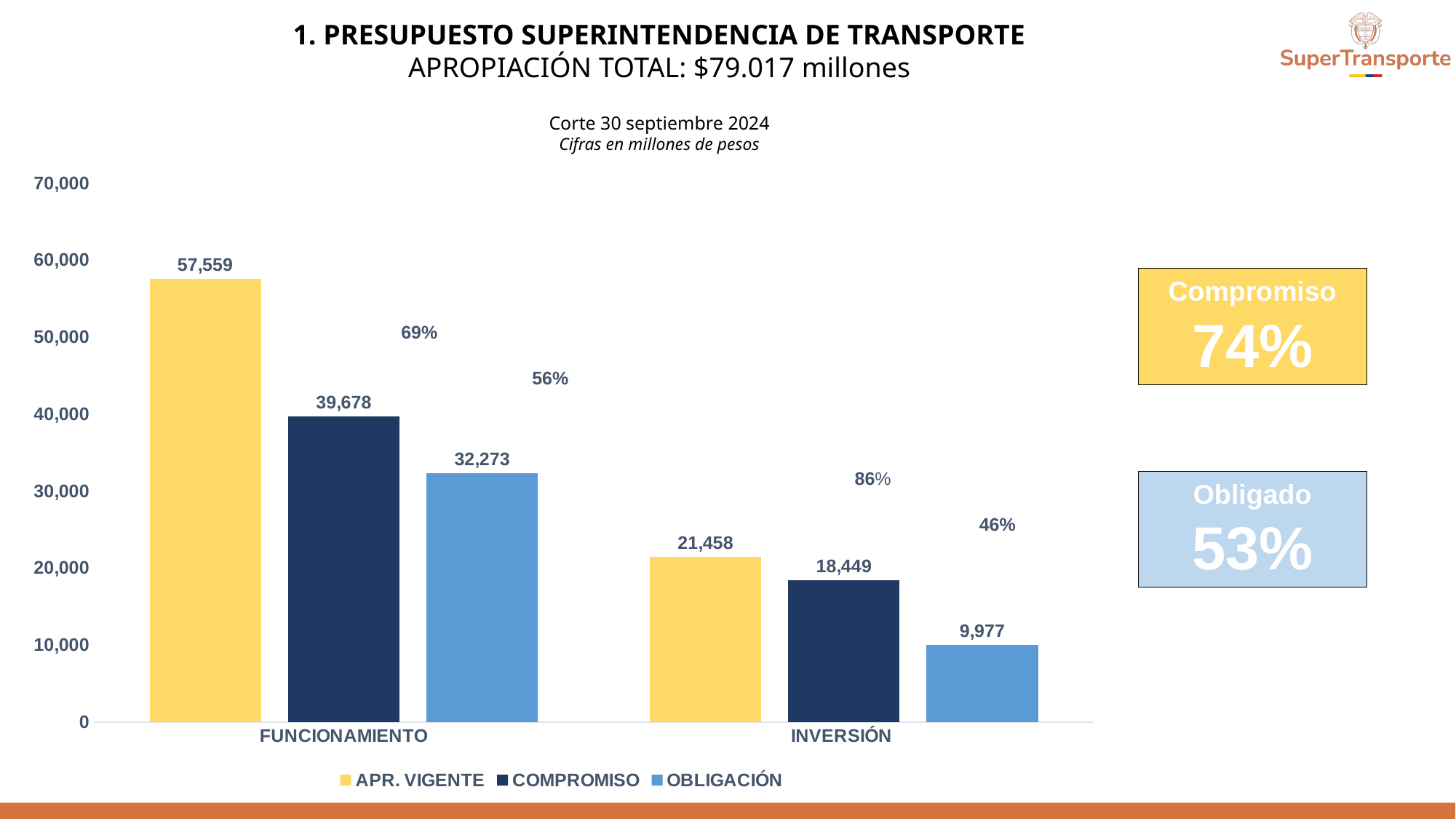
What kind of chart is shown on the slide? Bar chart Which bar has the highest value on the chart? APR. VIGENTE for FUNCIONAMIENTO How many series does the legend list? 3 Which bar has the lowest value on the chart? OBLIGACIÓN for INVERSIÓN What percentage is shown in the Compromiso box on the right of the slide? 74% What is the OBLIGACIÓN value for FUNCIONAMIENTO? 32,273 What is the difference between the APR. VIGENTE and COMPROMISO values for FUNCIONAMIENTO? 17,881 What is the OBLIGACIÓN value for INVERSIÓN? 9,977 What is the COMPROMISO value for INVERSIÓN? 18,449 How many categories are shown on the x axis? 2 Which is larger: the COMPROMISO value for INVERSIÓN or the APR. VIGENTE value for INVERSIÓN? APR. VIGENTE for INVERSIÓN What is the APR. VIGENTE value for FUNCIONAMIENTO? 57,559